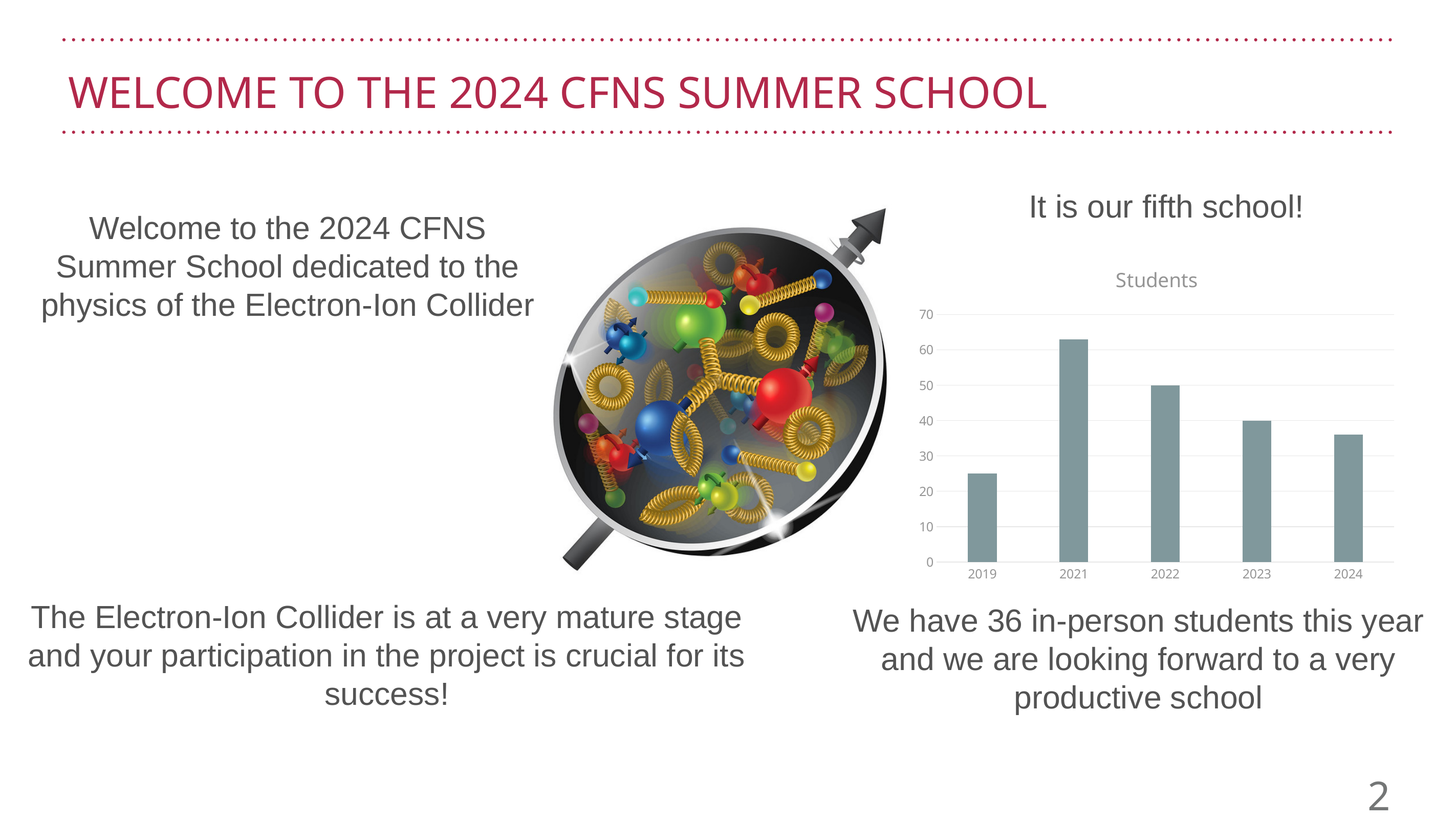
What is the number of students for 2022? 50 Which year has the highest number of students? 2021 Which year has the lowest number of students? 2019 What kind of chart is shown on the slide? bar chart Is the value for 2019 greater or less than 30? less Is the value for 2024 greater or less than 40? less What is the number of students for 2023? 40 Is the value for 2021 greater or less than 60? greater What is the title of the chart? Students What is the difference in students between 2022 and 2023? 10 Do the student numbers rise or fall from 2021 to 2024? fall How many years are shown on the x axis of the chart? 5